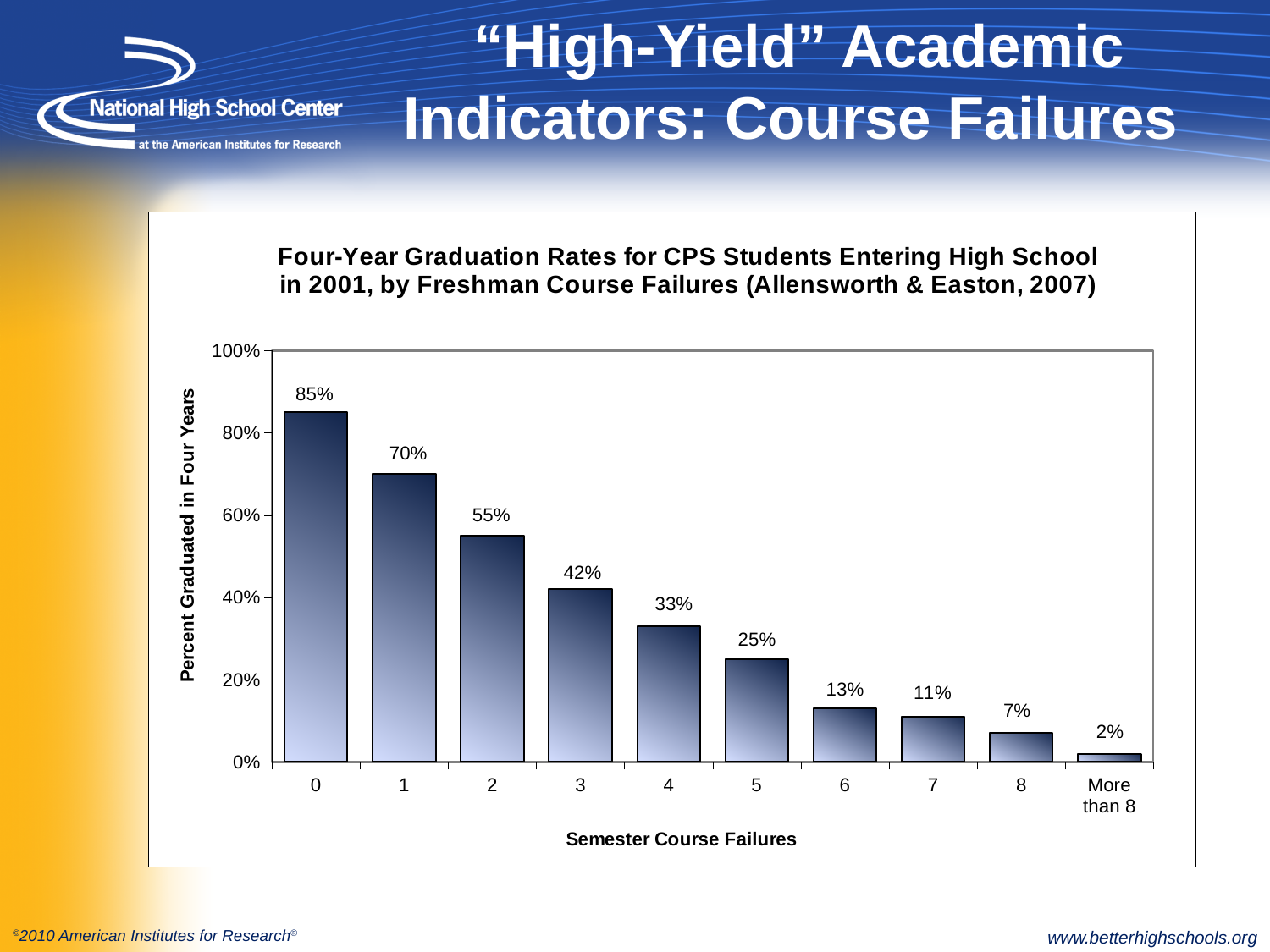
What is the four-year graduation rate for students with more than 8 semester course failures? 2% What is the four-year graduation rate for students with 0 semester course failures? 85% Is the graduation rate for students with 7 course failures greater or less than 20%? less Do graduation rates rise or fall as the number of semester course failures increases? Fall How many semester course failure categories are shown on the x axis? 10 Which semester course failure category has the lowest graduation rate? More than 8 What is the difference in graduation rate between students with 0 course failures and students with 5 course failures? 60% Which has a higher graduation rate: 4 course failures or 6 course failures? 4 course failures Which semester course failure category has the highest graduation rate? 0 What is the difference in graduation rate between students with 1 course failure and students with 2 course failures? 15% What kind of chart is shown on the slide? Bar chart What is the four-year graduation rate for students with 3 semester course failures? 42%